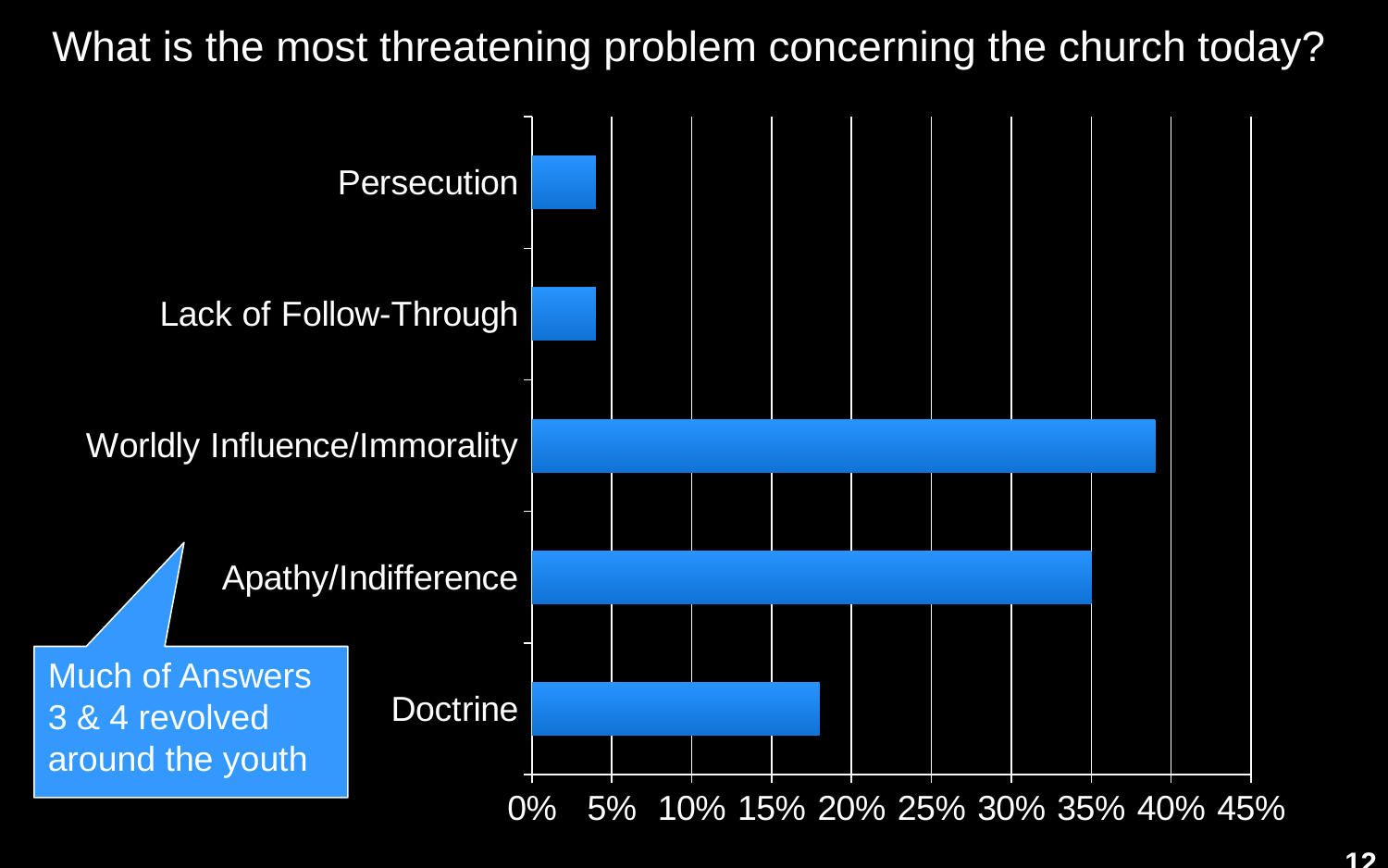
Which is larger, the value for Apathy/Indifference or the value for Doctrine? Apathy/Indifference Is the value for Lack of Follow-Through greater or less than 10%? less What is the highest value shown on the horizontal axis? 45% Which category has the highest value? Worldly Influence/Immorality Is the value for Persecution greater or less than 5%? less Is the value for Doctrine greater or less than 15%? greater What is the title of the chart? What is the most threatening problem concerning the church today? What kind of chart is shown on the slide? bar chart Which is larger, the value for Worldly Influence/Immorality or the value for Apathy/Indifference? Worldly Influence/Immorality How many categories are shown in the chart? 5